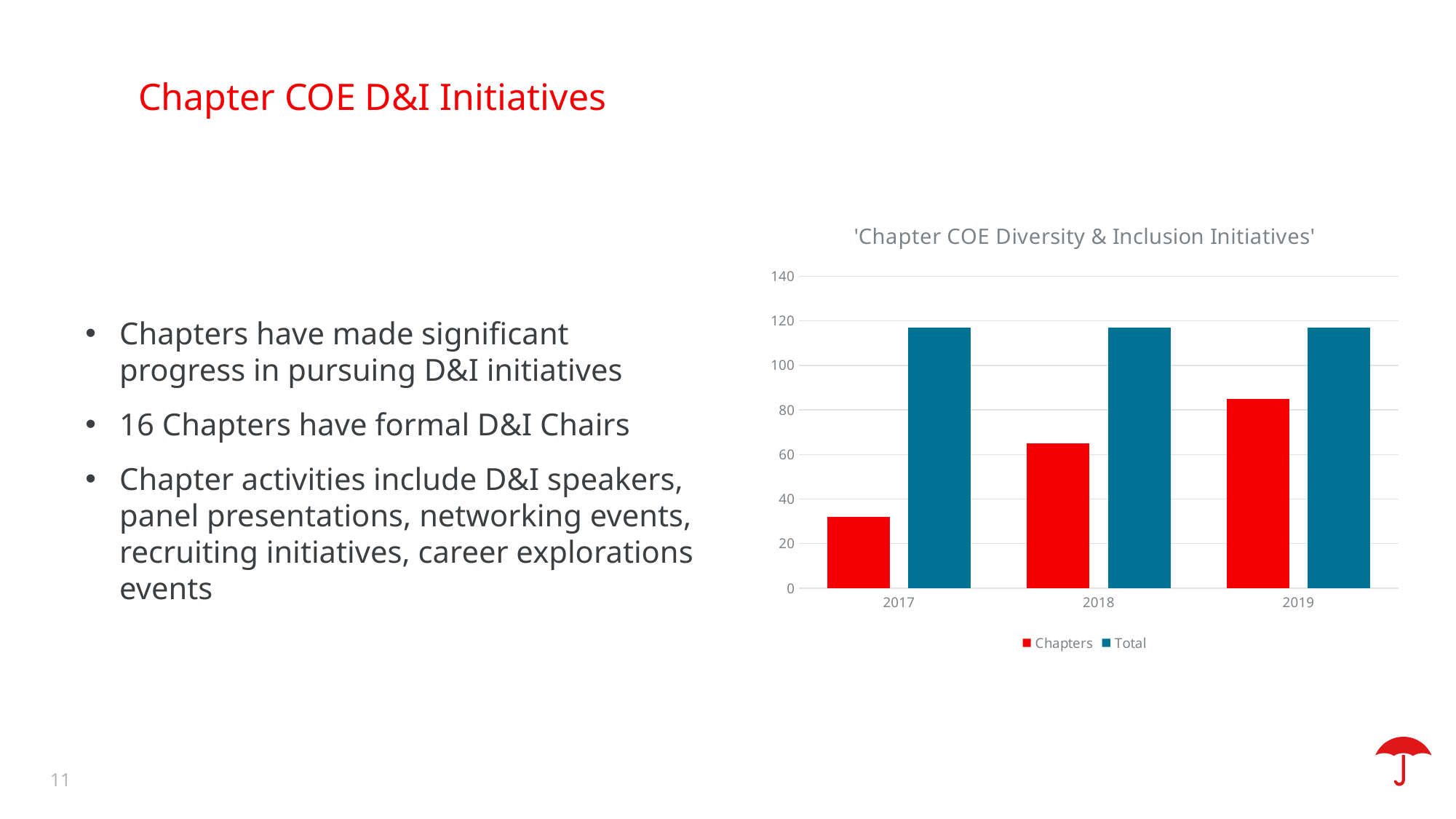
What kind of chart is shown on the slide? bar chart Is the value for Chapters in 2018 greater or less than 60? greater What is the title of the chart? 'Chapter COE Diversity & Inclusion Initiatives' Do the Chapters values rise or fall from 2017 to 2019? rise Which is larger in 2018, the Chapters value or the Total value? Total Which year has the lowest value for Chapters? 2017 How many years are shown on the x axis of the chart? 3 Which year has the highest value for Chapters? 2019 Is the value for Chapters in 2017 greater or less than 40? less Is the value for Chapters in 2019 greater or less than 80? greater How many series does the chart legend list? 2